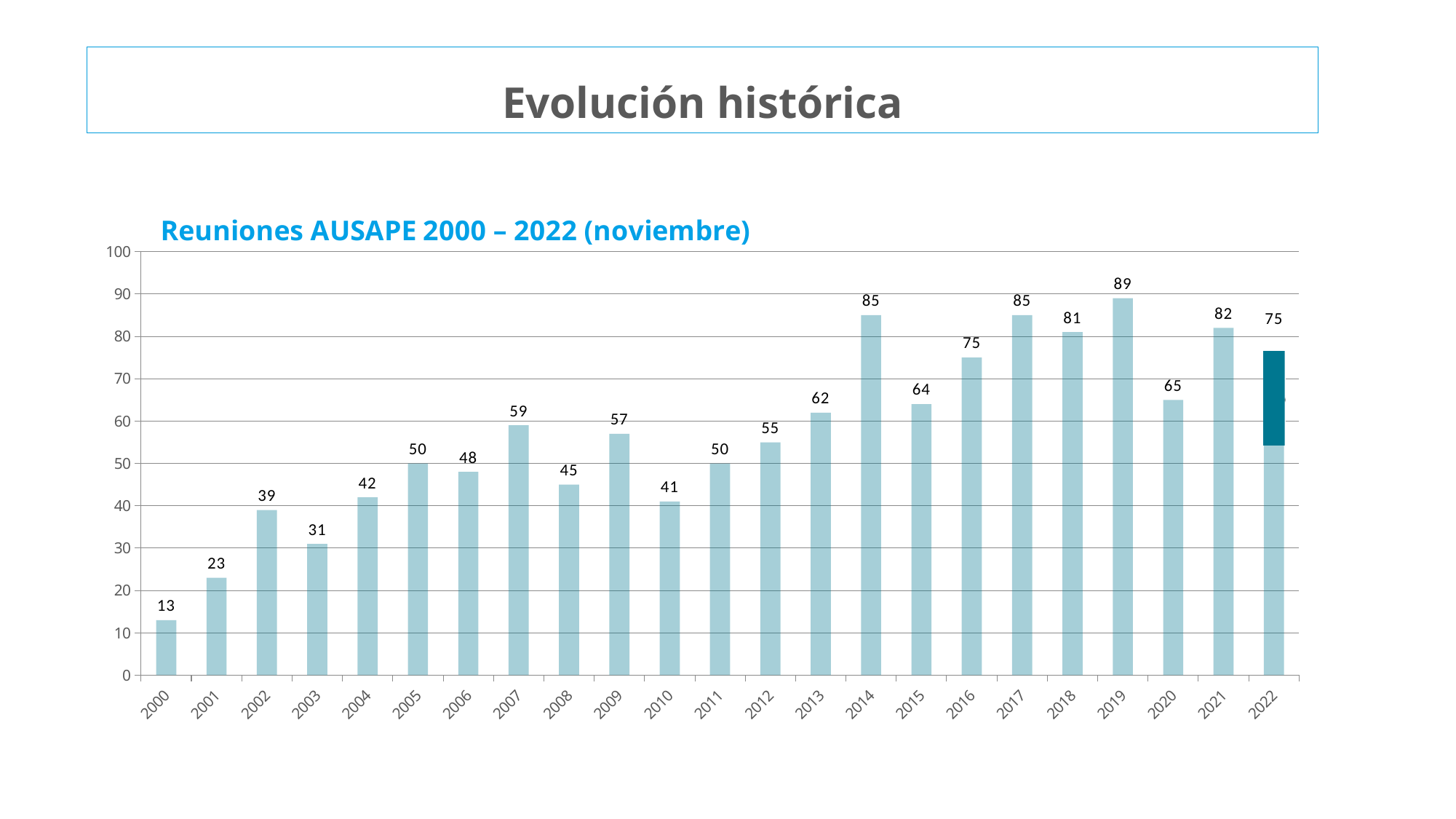
Which year has the highest value? 2019 Which is larger, the value for 2007 or the value for 2009? 2007 What kind of chart is shown? bar chart What is the value for 2000? 13 Do the values generally rise or fall from 2000 to 2019? rise What is the value for 2019? 89 What is the title of the chart? Reuniones AUSAPE 2000 – 2022 (noviembre) Is the value for 2014 greater or less than 80? greater Which year has the lowest value? 2000 What is the difference between the values for 2021 and 2020? 17 How many years are shown on the x axis? 23 What is the value for 2022? 75